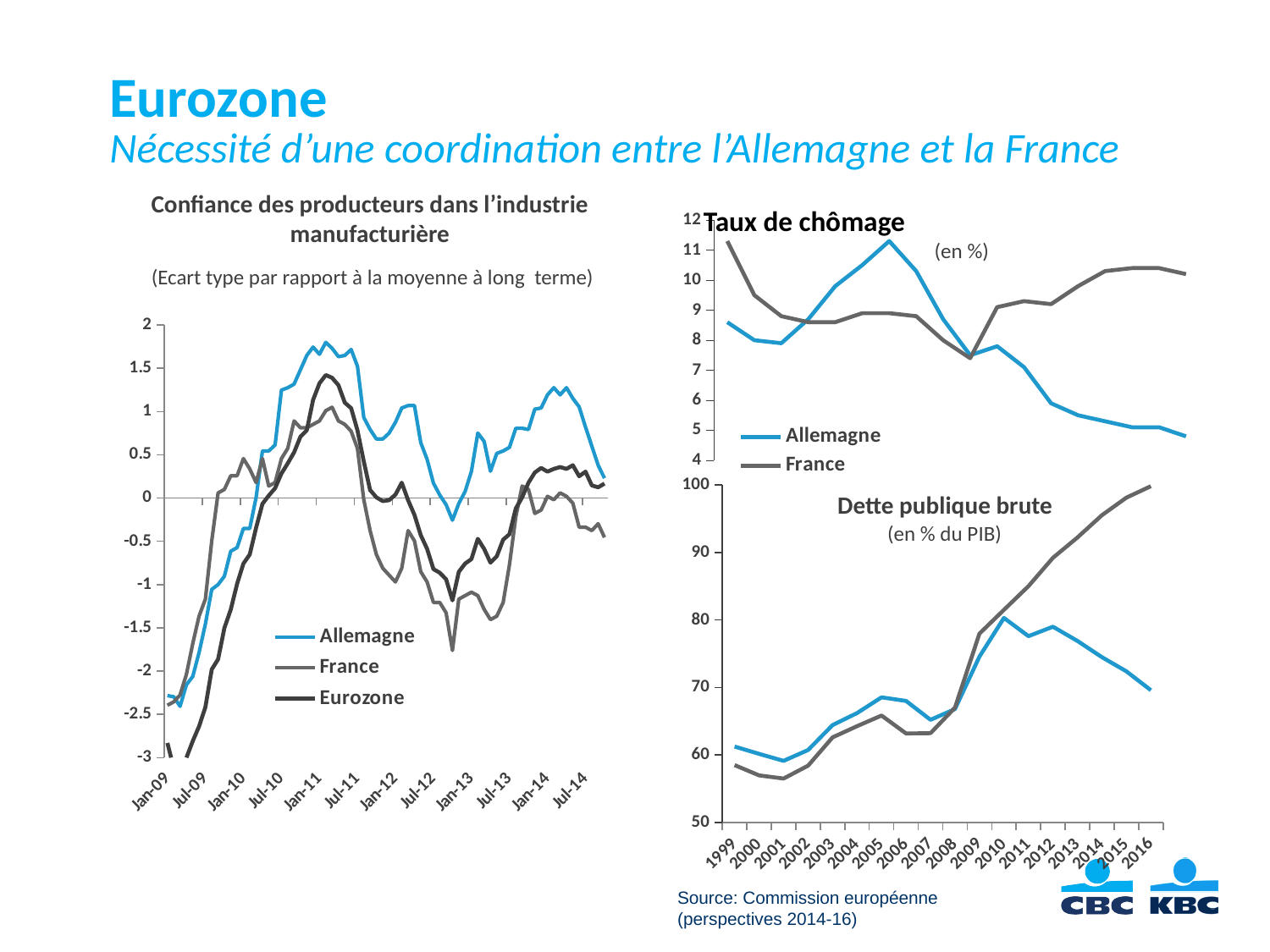
In the 'Dette publique brute' chart, does the value for France rise or fall from 2008 to 2016? rise In the 'Dette publique brute' chart, which is higher in 2016, Allemagne or France? France In the 'Taux de chômage' chart, does the value for Allemagne rise or fall from 2005 to 2016? fall What kind of chart is the 'Confiance des producteurs dans l'industrie manufacturière' chart? line chart In the 'Taux de chômage' chart, is the value for France in 1999 greater or less than 10? greater In the 'Taux de chômage' chart, which is higher in 2005, Allemagne or France? Allemagne In the 'Taux de chômage' chart, how many series does the legend list? 2 In the 'Dette publique brute' chart, is the value for France in 2016 greater or less than 90? greater In the 'Taux de chômage' chart, is the value for Allemagne in 2016 greater or less than 5? less How many series does the legend of the 'Confiance des producteurs dans l'industrie manufacturière' chart list? 3